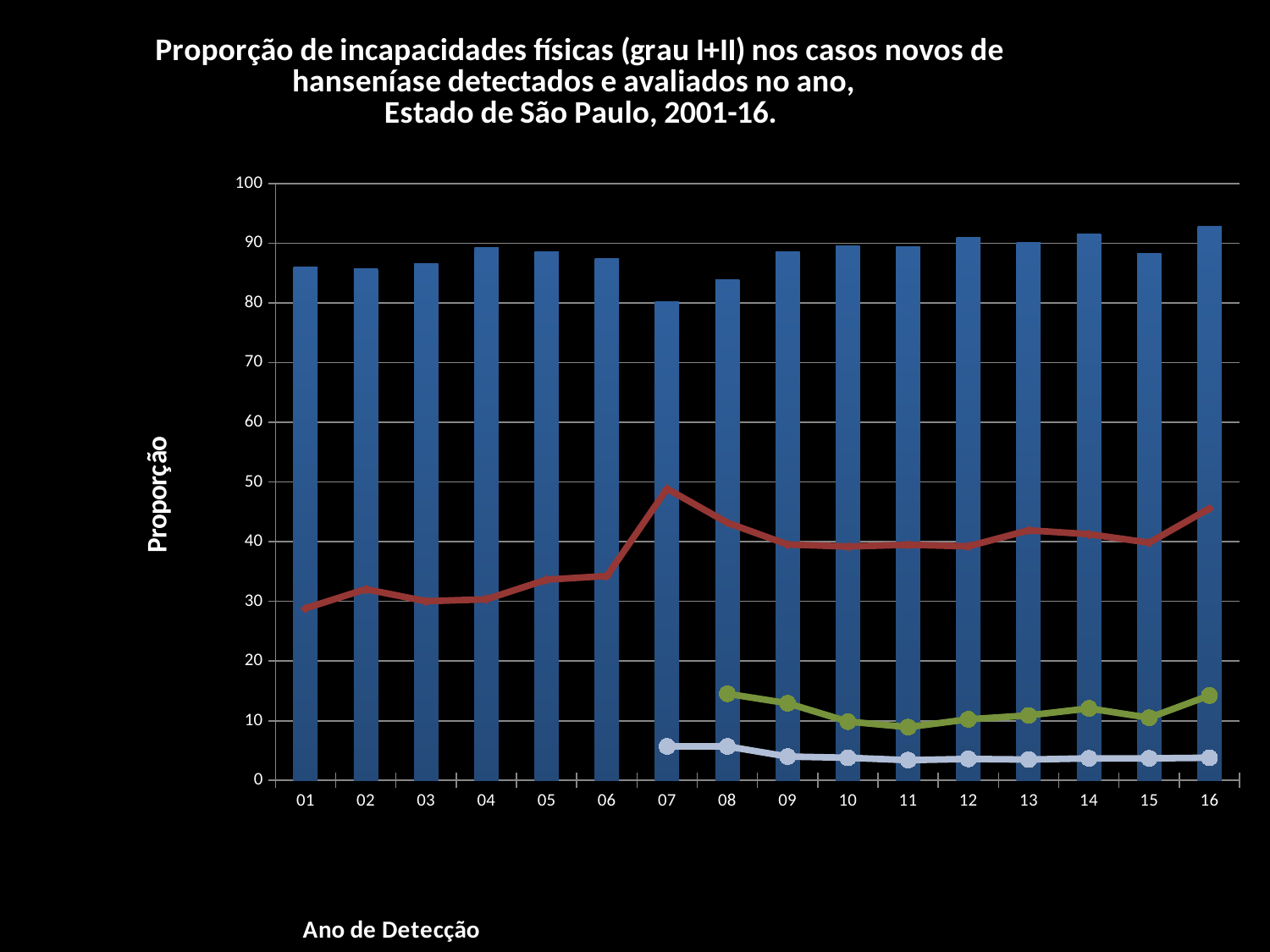
Is the light grey line value for year 16 greater or less than 10? less Which year has the lowest blue bar? 07 How many years (categories) are shown on the x axis? 16 Which blue bar is taller, year 07 or year 16? 16 Is the red line value for year 07 greater or less than 40? greater Is the blue bar for year 16 greater or less than 90? greater In which year does the red line reach its highest point? 07 What kind of chart is shown on the slide? A bar chart combined with line series Does the red line rise or fall overall from year 01 to year 07? rise What is the label of the y axis? Proporção